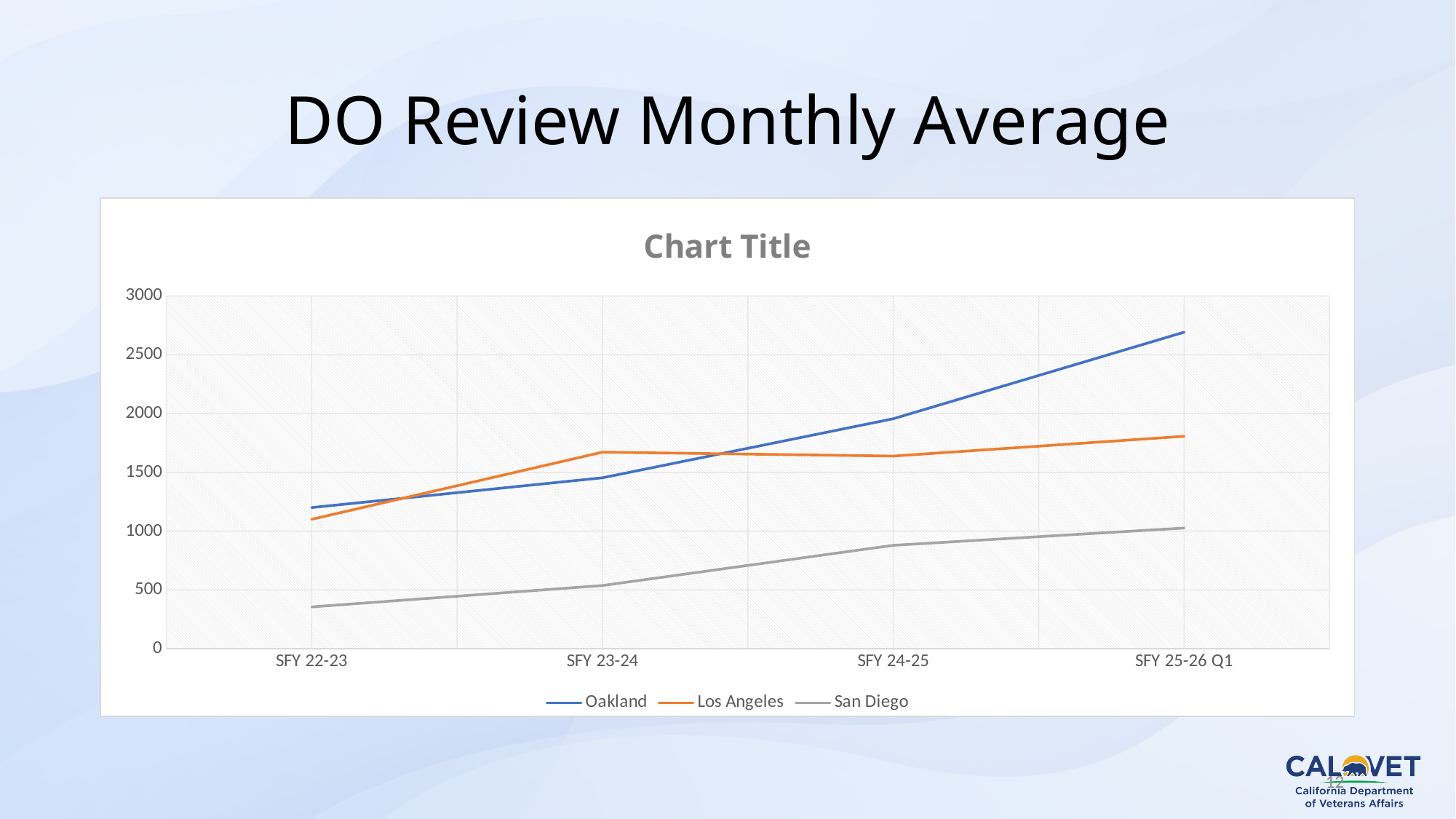
What colour is the Oakland line? blue Is the value for San Diego at SFY 24-25 greater or less than 1000? less Is the value for San Diego at SFY 22-23 greater or less than 500? less Which series has the lowest value at SFY 22-23? San Diego Which series has the highest value at SFY 25-26 Q1? Oakland Is the value for Oakland at SFY 25-26 Q1 greater or less than 2500? greater Does the San Diego line rise or fall from SFY 22-23 to SFY 25-26 Q1? rise How many categories are shown on the x axis? 4 At SFY 23-24, which is larger: Oakland or Los Angeles? Los Angeles What kind of chart is shown on the slide? line chart How many series does the legend list? 3